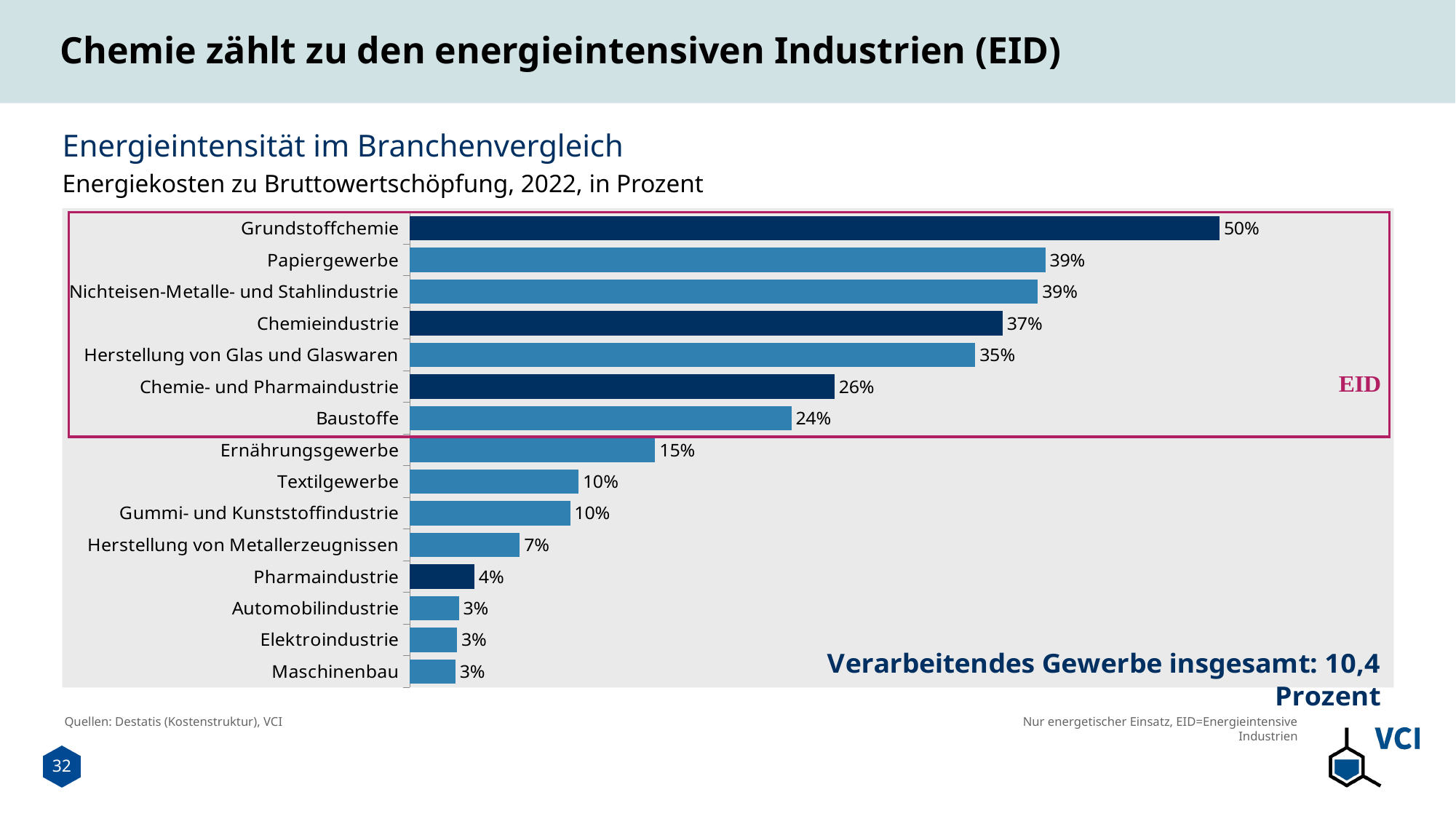
What is the value for Baustoffe? 24% Which is larger, the value for Pharmaindustrie or the value for Herstellung von Metallerzeugnissen? Herstellung von Metallerzeugnissen What is the value for Grundstoffchemie? 50% What kind of chart is shown on the slide? Bar chart How many categories are shown in the chart? 15 What is the difference between the values for Grundstoffchemie and Chemieindustrie? 13% What is the difference between the values for Herstellung von Glas und Glaswaren and Baustoffe? 11% What is the value for Ernährungsgewerbe? 15% Which is larger, the value for Chemie- und Pharmaindustrie or the value for Ernährungsgewerbe? Chemie- und Pharmaindustrie What is the value for Chemieindustrie? 37% Which category has the highest value? Grundstoffchemie What is the title of the chart? Energieintensität im Branchenvergleich